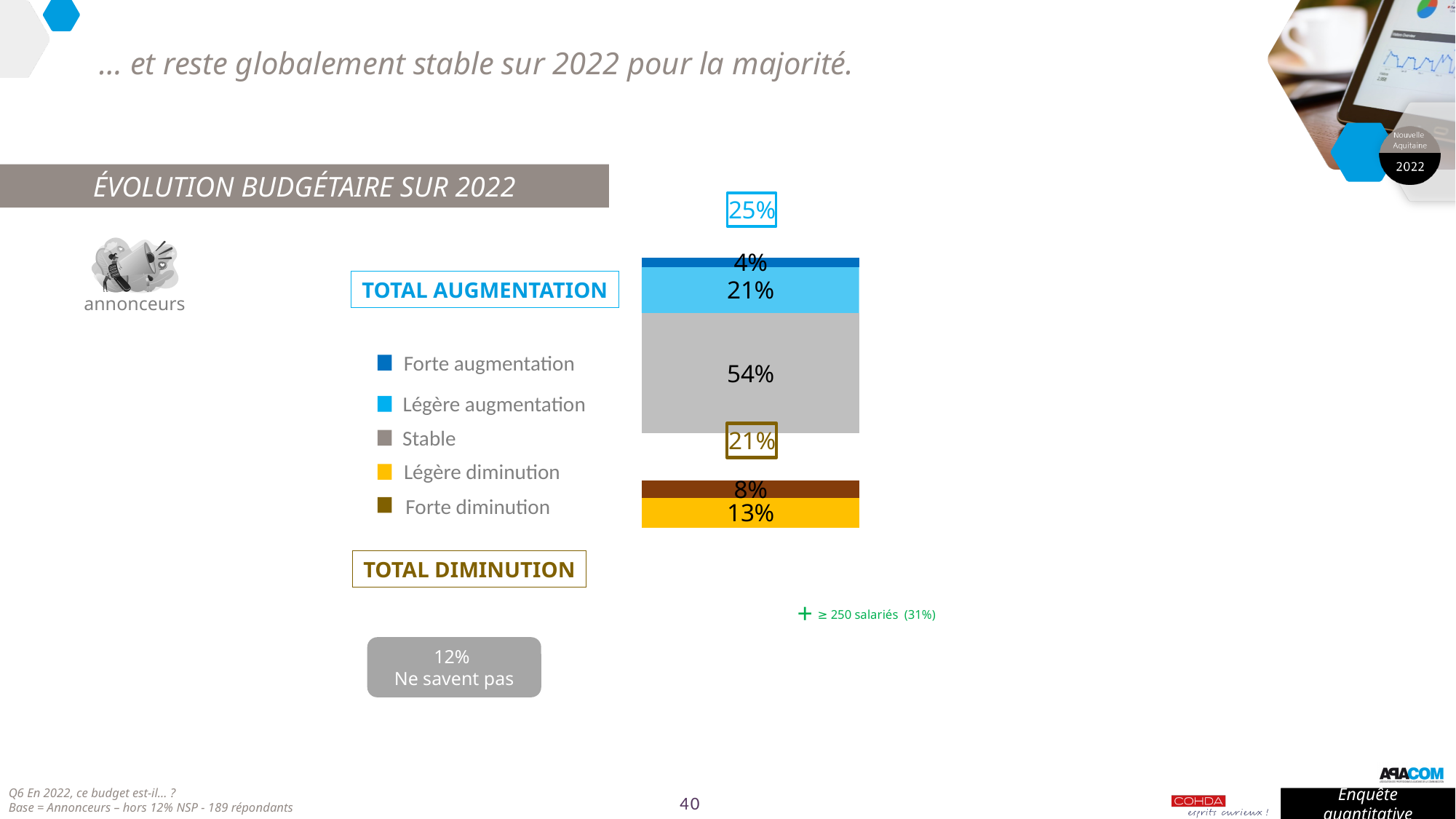
Which category has the highest value? Stable What kind of chart is shown on the slide? Stacked bar chart Which is larger, 'Forte diminution' or 'Forte augmentation'? Forte diminution How many entries does the legend list? 5 What is the difference between 'Légère augmentation' and 'Légère diminution'? 8% Which category has the lowest value? Forte augmentation What is the value for 'Forte augmentation'? 4% What percentage of advertisers reported a 'Stable' budget in 2022? 54% What is the 'TOTAL AUGMENTATION' figure shown on the chart? 25% What is the value for 'Forte diminution'? 8% What is the 'TOTAL DIMINUTION' figure shown on the chart? 21% What is the value for 'Légère diminution'? 13%